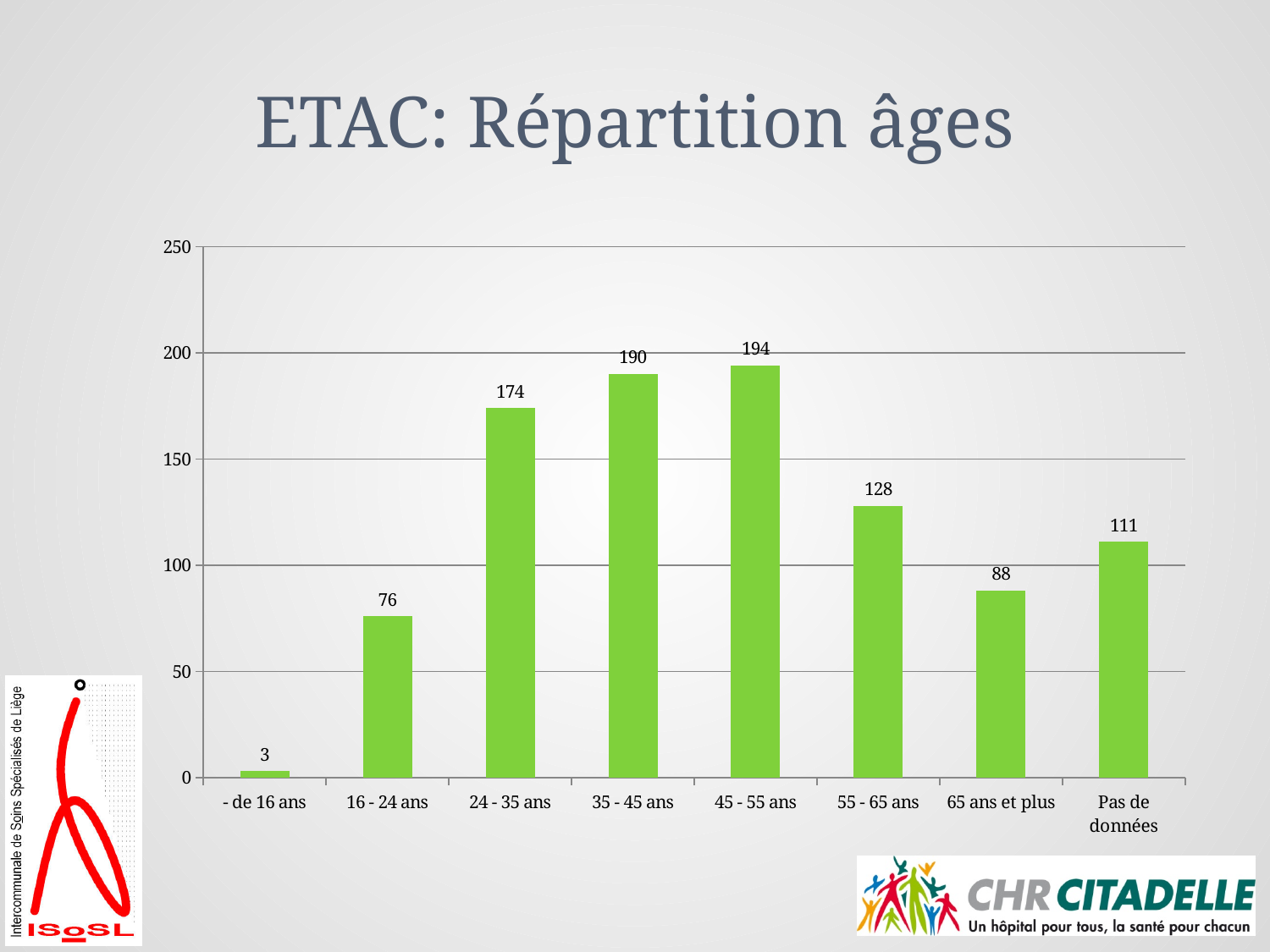
What is the title of the chart on the slide? ETAC: Répartition âges Which age category has the highest value? 45 - 55 ans What kind of chart is shown on the slide? bar chart Which is larger, the value for 24 - 35 ans or the value for 65 ans et plus? 24 - 35 ans Is the value for 55 - 65 ans greater or less than 150? less Do the values rise or fall from 45 - 55 ans to 65 ans et plus? fall What is the value for the 35 - 45 ans category? 190 What is the value for the 16 - 24 ans category? 76 Which age category has the lowest value? - de 16 ans How many categories are shown on the x axis? 8 What is the value for the 'Pas de données' category? 111 What is the difference between the values for 45 - 55 ans and 55 - 65 ans? 66